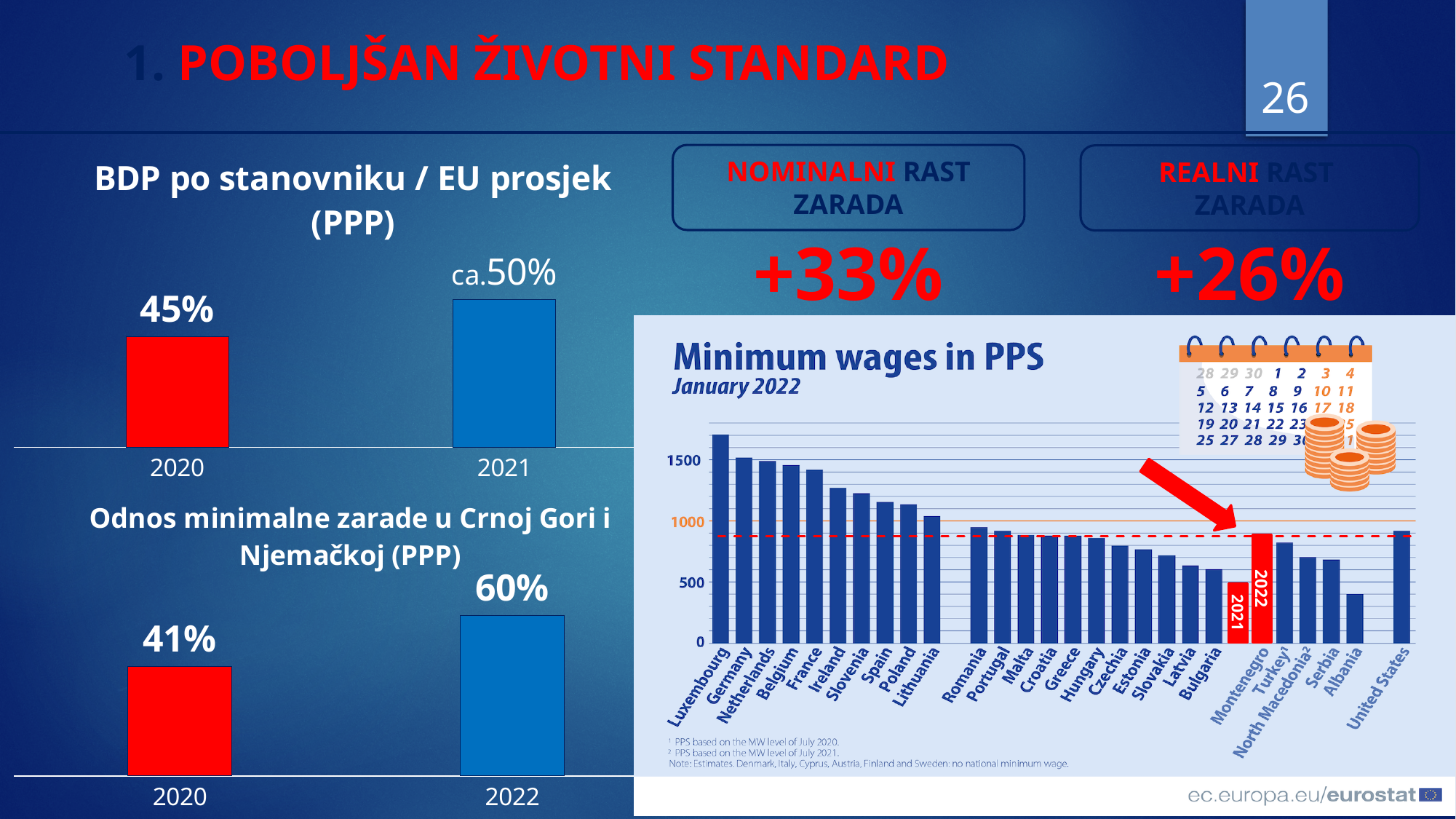
In the 'Minimum wages in PPS' chart, is the value for Albania greater or less than 500? less In the 'Minimum wages in PPS' chart, is the 2022 value for Montenegro greater or less than 1000? less What kind of chart is the 'Minimum wages in PPS' chart? Bar chart In the 'Minimum wages in PPS' chart, which Montenegro bar is taller, 2021 or 2022? 2022 In the 'Minimum wages in PPS' chart, which country has the lowest minimum wage? Albania In the 'Odnos minimalne zarade u Crnoj Gori i Njemačkoj (PPP)' chart, what is the value for 2022? 60% In the 'BDP po stanovniku / EU prosjek (PPP)' chart, what is the value for 2020? 45% In the 'BDP po stanovniku / EU prosjek (PPP)' chart, which year has the higher value, 2020 or 2021? 2021 In the 'Odnos minimalne zarade u Crnoj Gori i Njemačkoj (PPP)' chart, what is the difference between the 2022 and 2020 values? 19 percentage points In the 'Odnos minimalne zarade u Crnoj Gori i Njemačkoj (PPP)' chart, what is the value for 2020? 41% In the 'Minimum wages in PPS' chart, is the value for Luxembourg greater or less than 1500? greater In the 'Minimum wages in PPS' chart, which country has the highest minimum wage? Luxembourg